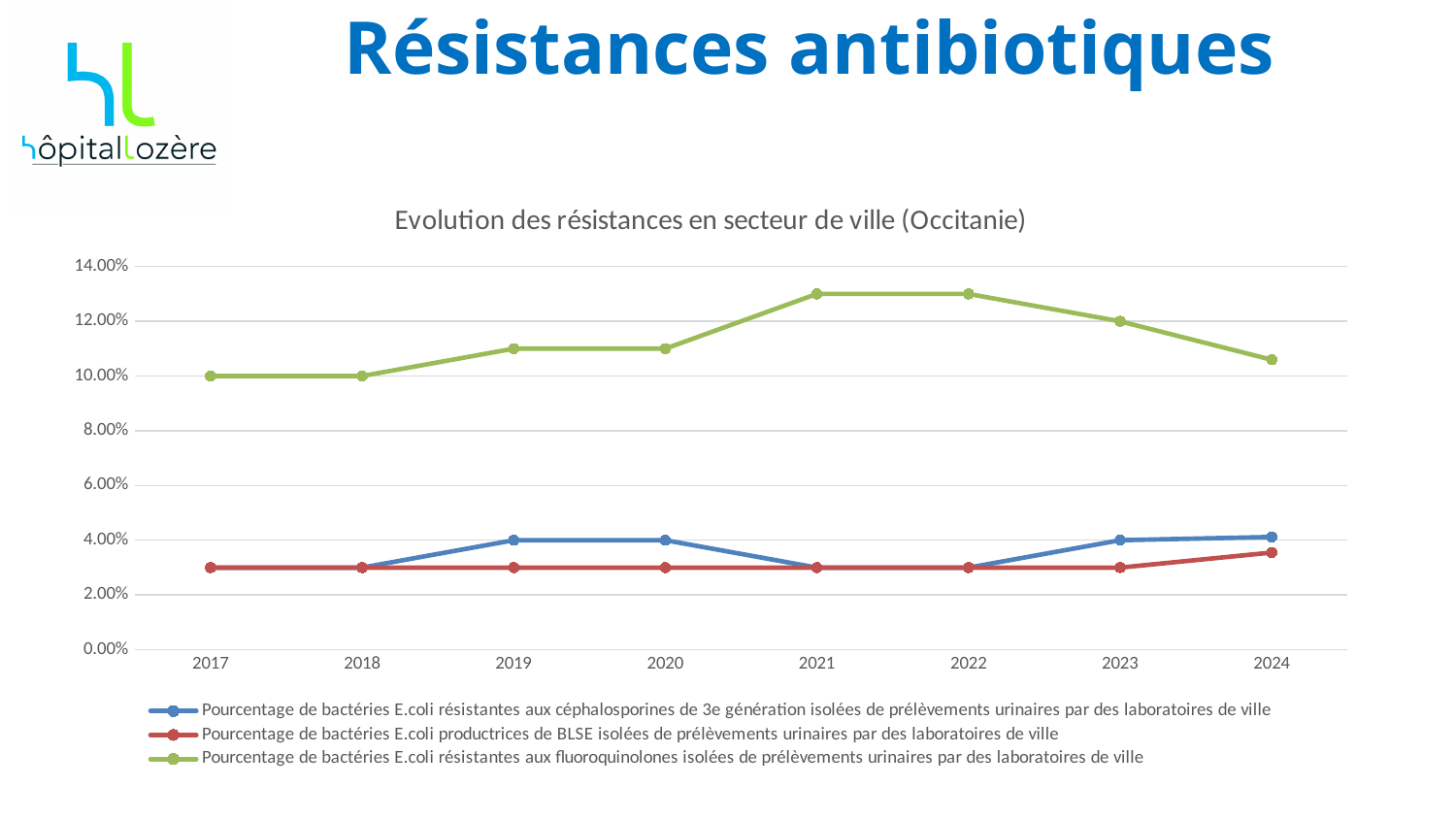
Is the value of the céphalosporines de 3e génération series (blue line) in 2021 greater or less than 4.00%? less How many years are shown on the x axis? 8 What is the value of the céphalosporines de 3e génération series (blue line) in 2019? 4.00% How many series does the legend list? 3 In 2020, which series has the higher value: the fluoroquinolones series or the céphalosporines de 3e génération series? fluoroquinolones series What is the value of the fluoroquinolones series (green line) in 2017? 10.00% Is the value of the fluoroquinolones series (green line) in 2021 greater or less than 12.00%? greater What is the value of the fluoroquinolones series (green line) in 2023? 12.00% Is the value of the BLSE series (red line) in 2024 greater or less than 4.00%? less What is the title of the chart? Evolution des résistances en secteur de ville (Occitanie) What type of chart is shown on the slide? line chart Does the fluoroquinolones series (green line) rise or fall from 2022 to 2024? fall